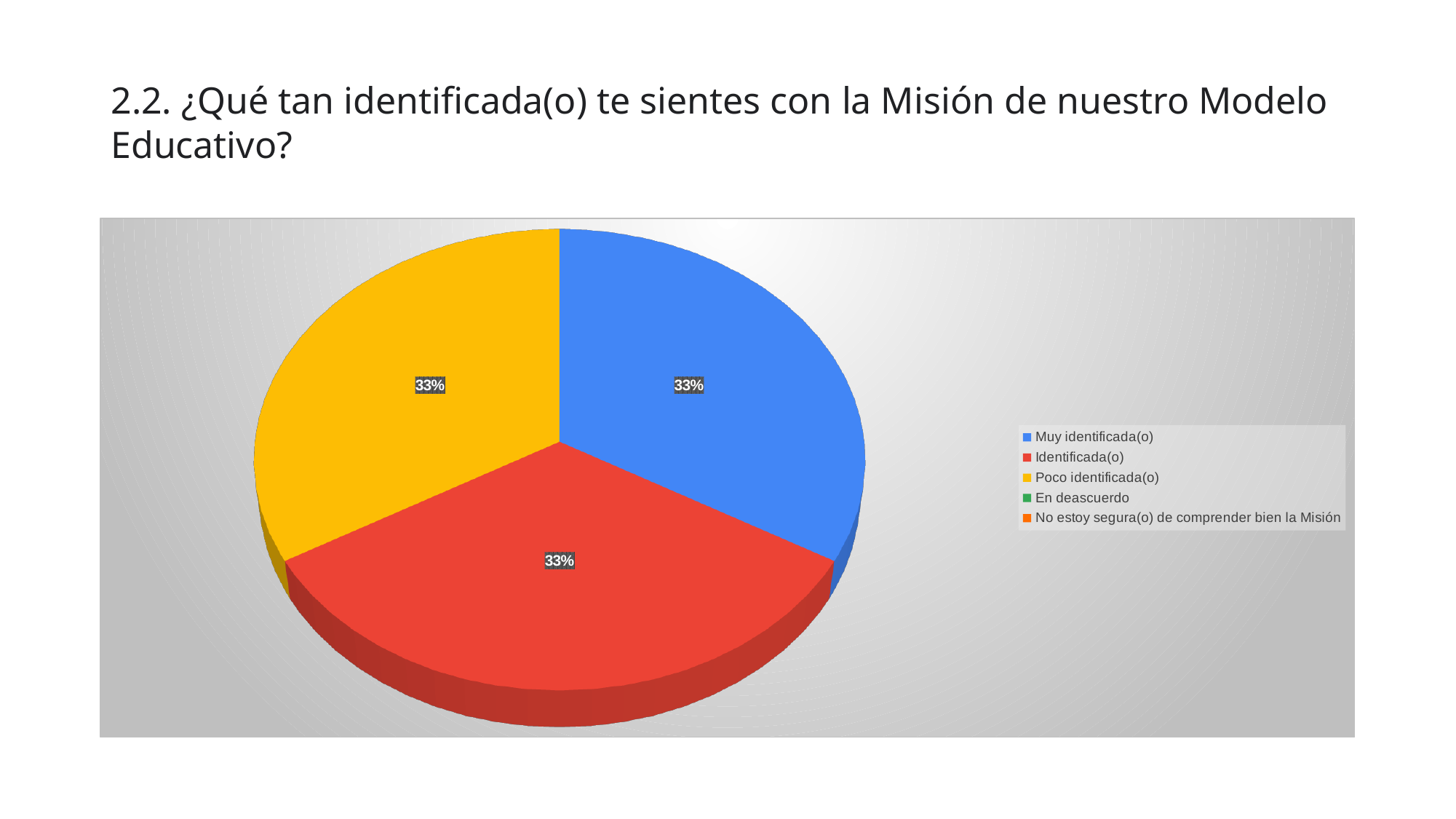
What percentage is shown for Muy identificada(o)? 33% What percentage is shown for Poco identificada(o)? 33% What colour is the slice for Identificada(o)? red How many slices are visible in the pie chart? 3 What percentage is shown for Identificada(o)? 33% What kind of chart is shown on the slide? pie chart Which legend entry is shown in blue? Muy identificada(o) How many entries does the legend list? 5 What share of the pie does the Poco identificada(o) slice represent? 33%